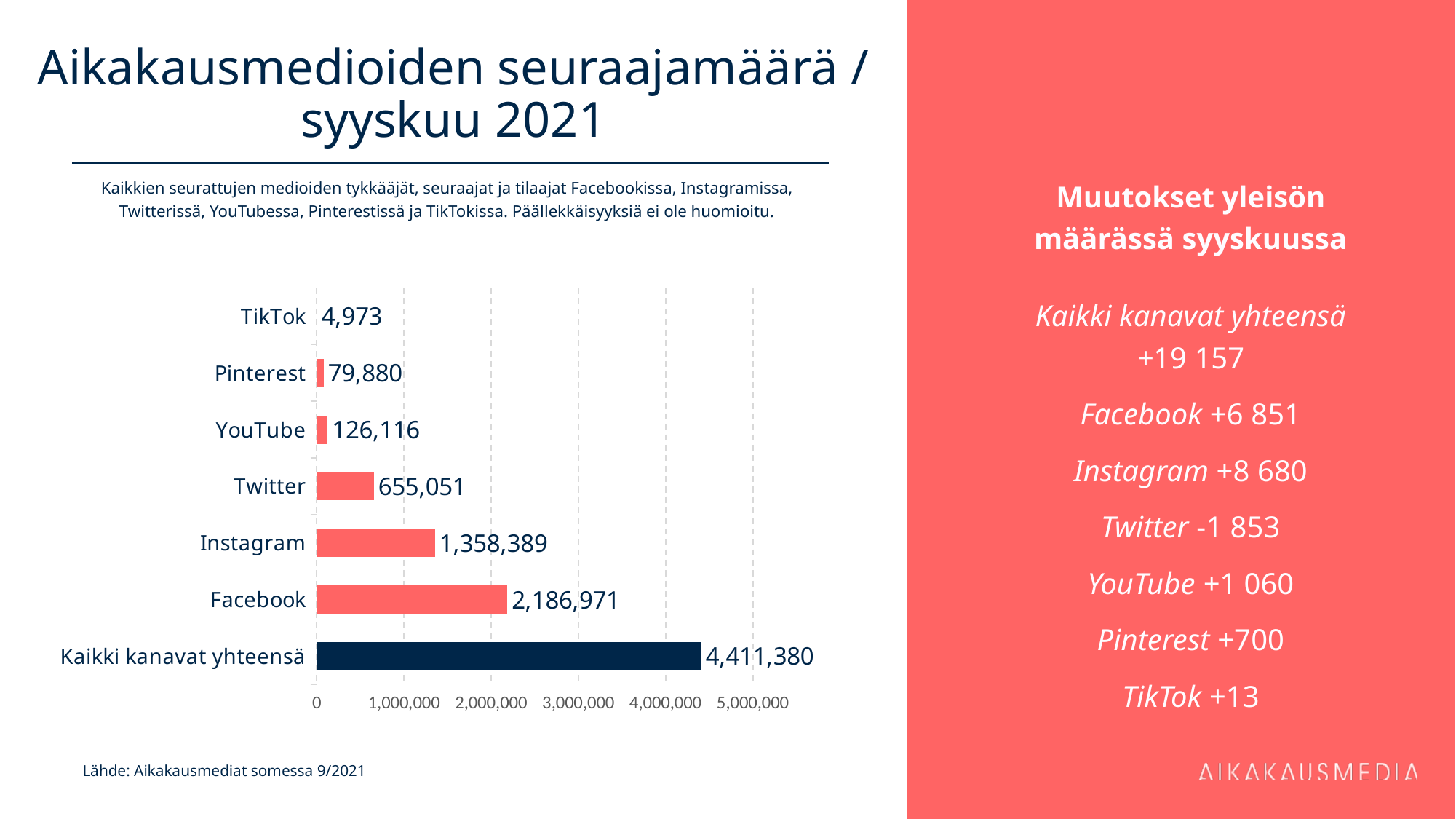
Which category has the highest value in the bar chart? Kaikki kanavat yhteensä Which category has the lowest value in the bar chart? TikTok What is the difference between the values for Facebook and Instagram? 828,582 How many categories are shown in the bar chart? 7 What is the value for Kaikki kanavat yhteensä in the bar chart? 4,411,380 What is the difference between the values for YouTube and Pinterest? 46,236 What is the value for Facebook in the bar chart? 2,186,971 Is the value for Facebook greater or less than 2,000,000? greater What is the value for Instagram in the bar chart? 1,358,389 What kind of chart is shown on the slide? bar chart What is the value for TikTok in the bar chart? 4,973 Which is larger, the value for Twitter or the value for YouTube? Twitter